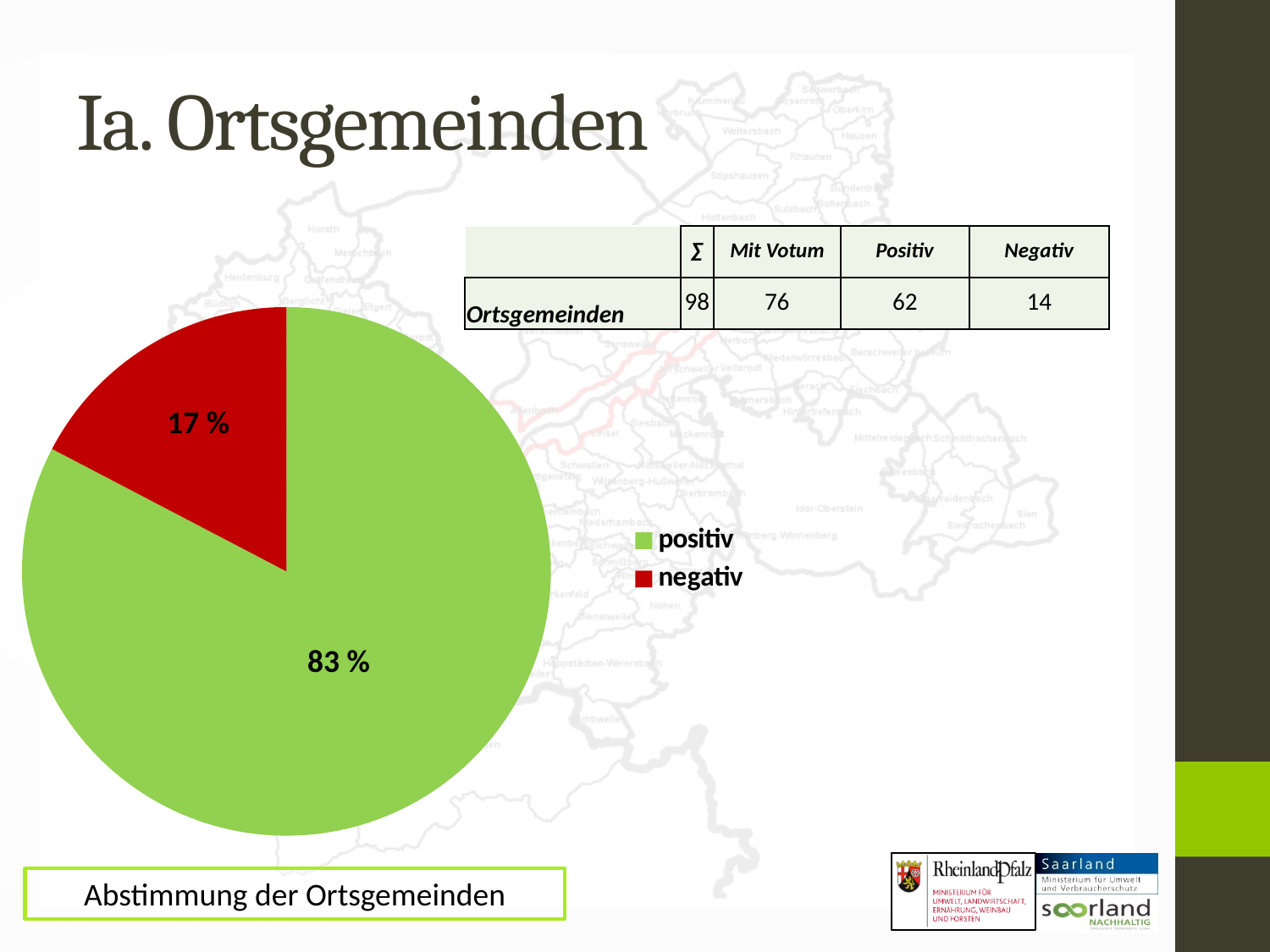
How many entries does the legend of the pie chart list? 2 What percentage does the negativ slice show in the pie chart? 17 % Which slice of the pie chart is the largest? positiv How many slices does the pie chart have? 2 What percentage does the positiv slice show in the pie chart? 83 % Which slice of the pie chart is the smallest? negativ What kind of chart is shown on the slide? pie chart What share of the pie does the negativ slice take? 17 % What colour is the negativ slice in the pie chart? red What is the difference in percentage points between the positiv and negativ slices? 66 % Which is larger in the pie chart, positiv or negativ? positiv What colour is the positiv slice in the pie chart? green